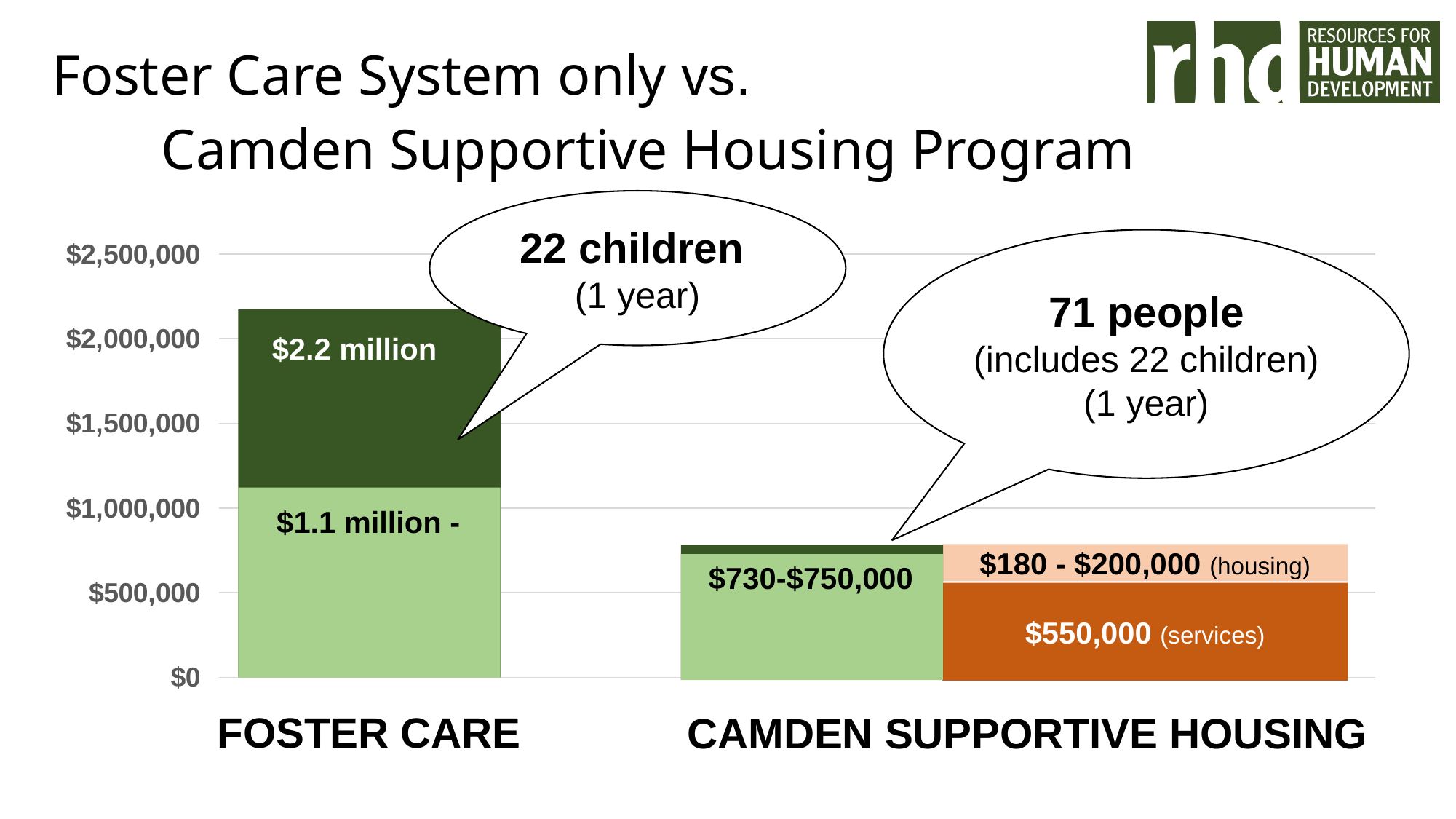
What value is labelled on the light green lower segment of the Foster Care bar? $1.1 million What is the labelled cost of housing in the Camden Supportive Housing breakdown? $180 - $200,000 What is the labelled cost of services in the Camden Supportive Housing breakdown? $550,000 Which category has the taller bar, Foster Care or Camden Supportive Housing? Foster Care What cost is labelled on the Camden Supportive Housing bar? $730-$750,000 How many categories are shown on the x axis of the chart? 2 What is the highest tick label shown on the y axis? $2,500,000 Is the value for the Foster Care bar greater or less than $2,000,000? greater Is the value for the Camden Supportive Housing bar greater or less than $1,000,000? less Which category has the shorter bar? Camden Supportive Housing What kind of chart is shown on the slide? bar chart According to the callout, how many children does the Foster Care bar cover in 1 year? 22 children